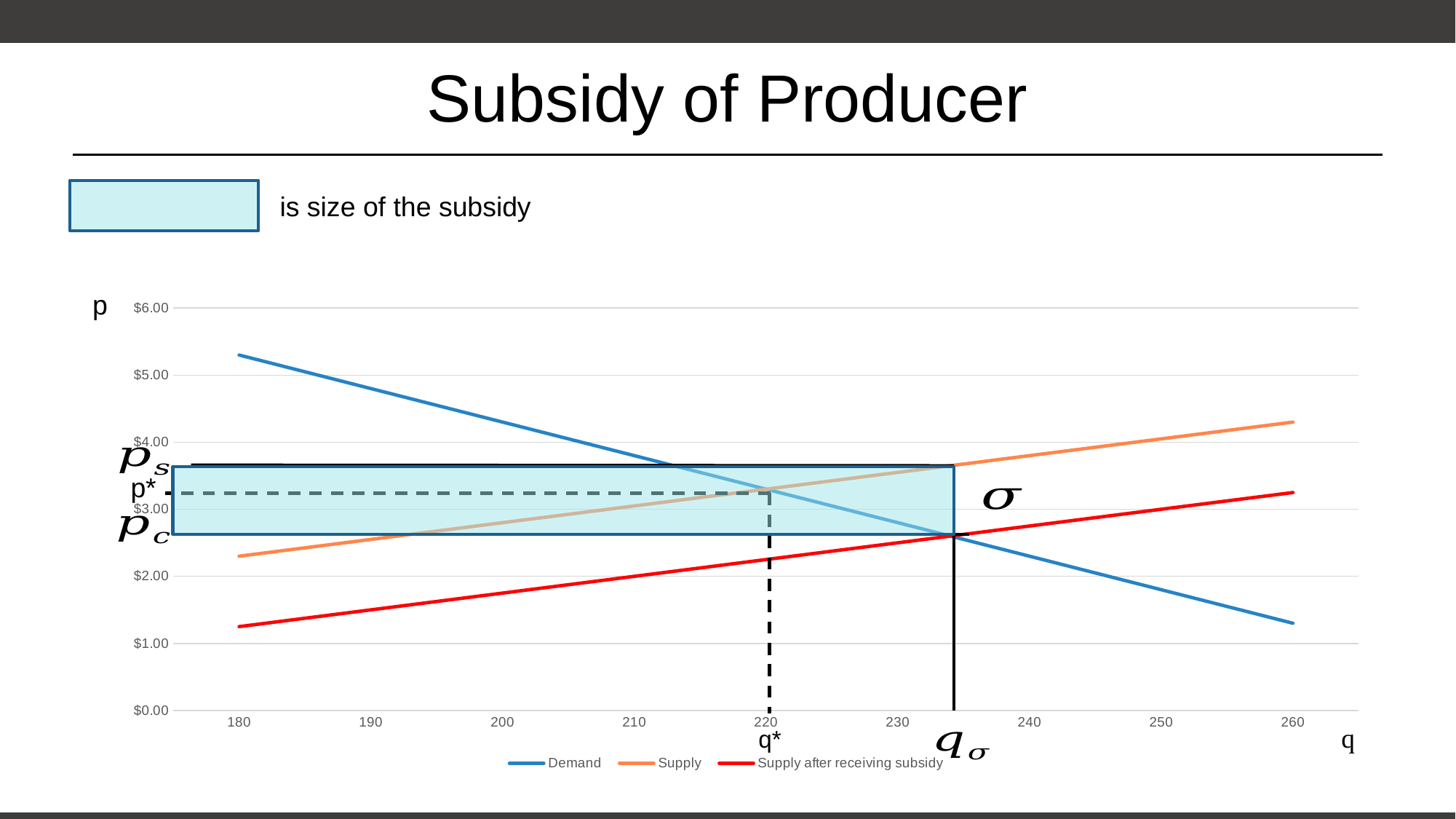
Is the value of the Supply after receiving subsidy line at q = 180 greater or less than $2.00? less At q = 180, which is higher, the Demand line or the Supply line? Demand At q = 260, which is higher, the Supply line or the Demand line? Supply Does the Supply line rise or fall as q increases along the x axis? rise Is the value of the Demand line at q = 180 greater or less than $5.00? greater What kind of chart is shown on the slide? line chart Is the value of the Supply line at q = 260 greater or less than $4.00? greater Which series are listed in the chart's legend? Demand, Supply, Supply after receiving subsidy Does the Demand line rise or fall as q increases along the x axis? fall How many series does the chart's legend list? 3 Which series has the lowest value at q = 180? Supply after receiving subsidy According to the slide, what does the shaded light-blue rectangle represent? the size of the subsidy